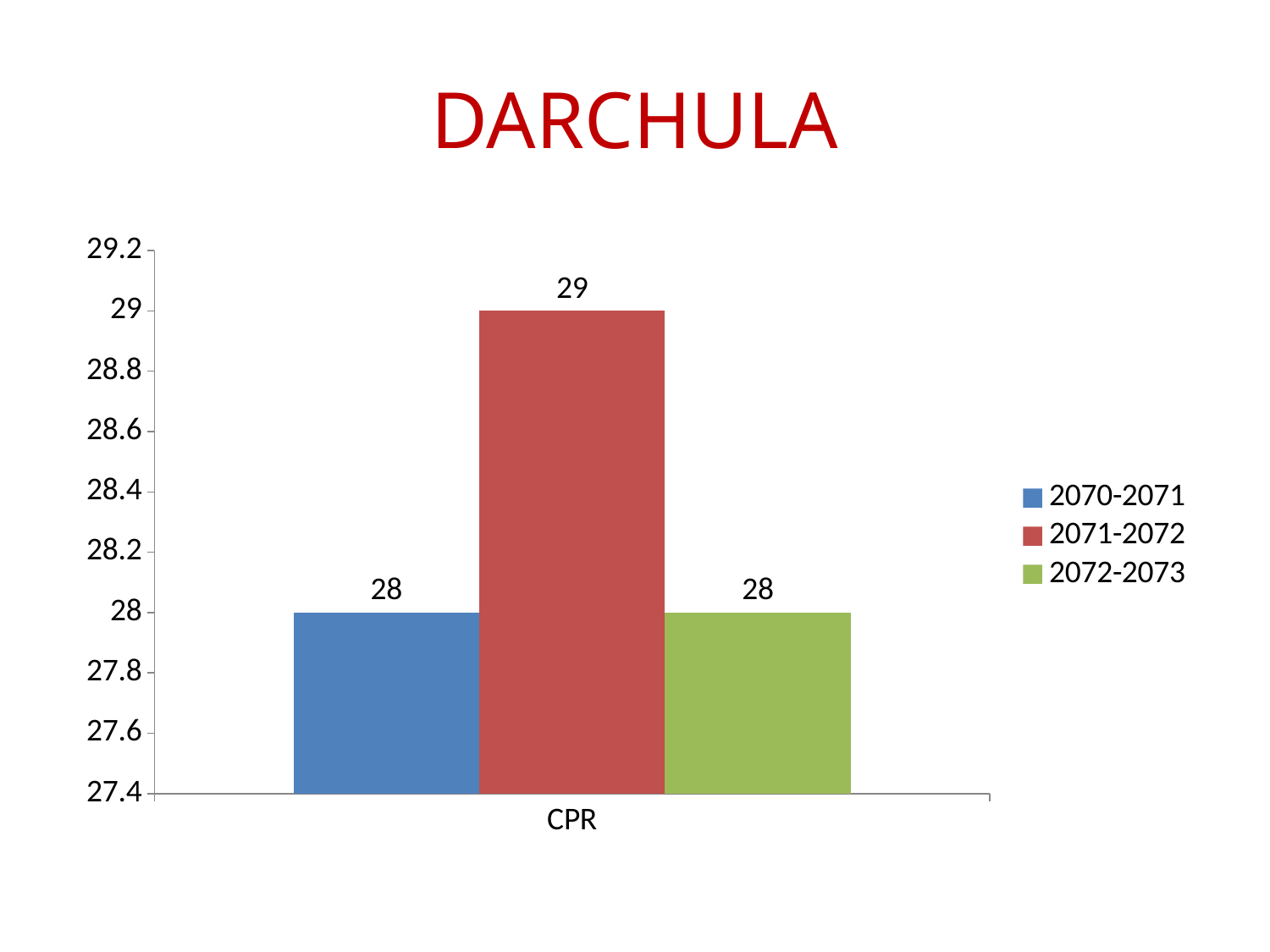
What is the difference between the CPR values for 2071-2072 and 2070-2071? 1 How many series does the legend list? 3 What kind of chart is shown on the slide? bar chart Which series has the highest CPR value? 2071-2072 Which is larger, the CPR value for 2071-2072 or for 2072-2073? 2071-2072 What is the CPR value for 2070-2071? 28 What is the CPR value for 2071-2072? 29 Is the CPR value for 2071-2072 greater or less than 28.6? greater What is the category label on the x axis? CPR Is the CPR value for 2070-2071 greater or less than 28.4? less What is the CPR value for 2072-2073? 28 What is the title of the slide? DARCHULA